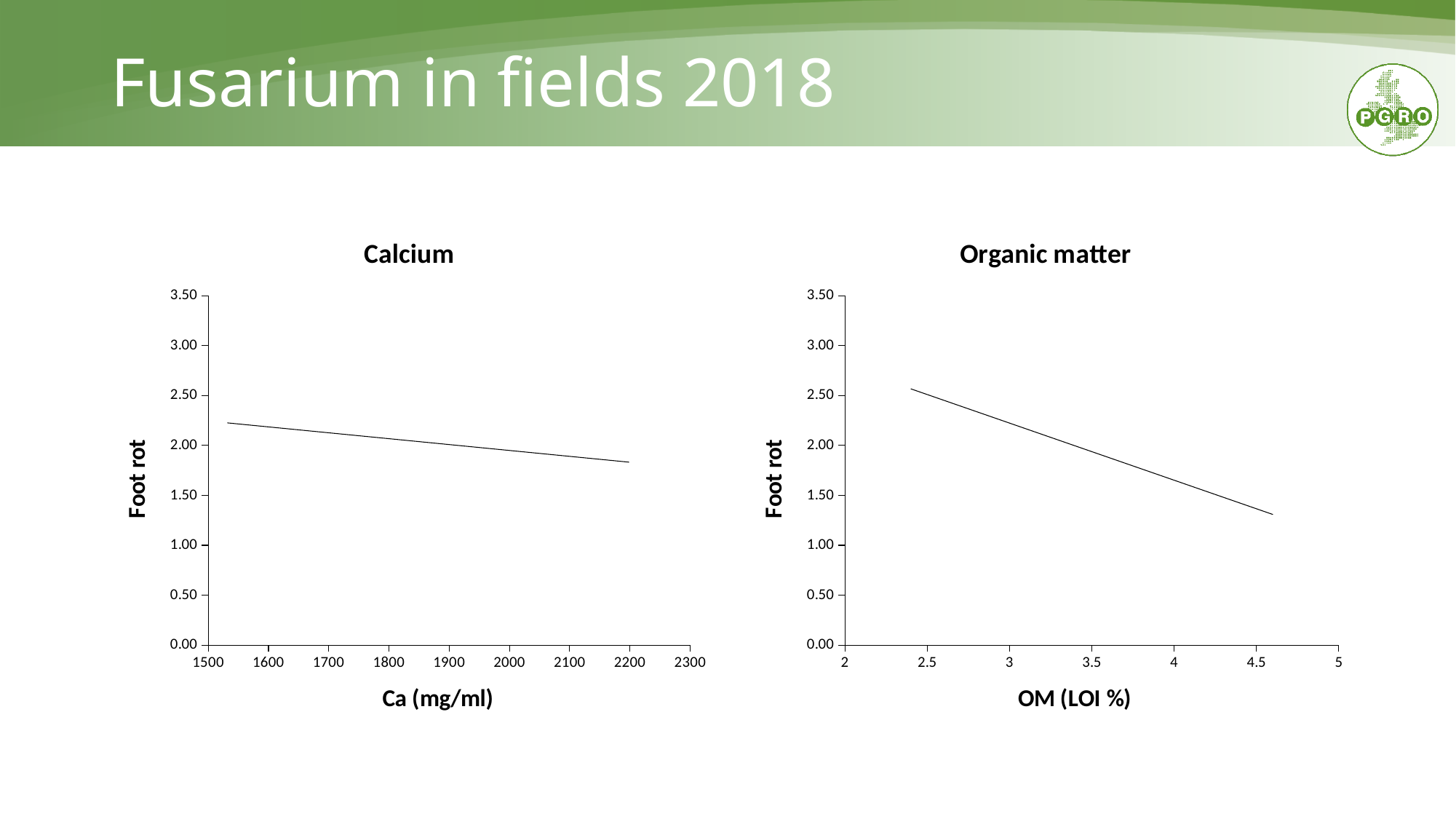
In the Organic matter chart, is the foot rot value at OM 4.5 (LOI %) greater or less than 1.50? less What is the x-axis label of the Calcium chart? Ca (mg/ml) In the Calcium chart, is the foot rot value at Ca 2200 mg/ml greater or less than 2.00? less What kind of chart is the Organic matter chart? line chart In the Organic matter chart, is the foot rot value at OM 3 (LOI %) greater or less than 2.00? greater What kind of chart is the Calcium chart? line chart In the Organic matter chart, does foot rot rise or fall as OM (LOI %) increases? fall What is the y-axis label of the Organic matter chart? Foot rot In the Calcium chart, does foot rot rise or fall as Ca (mg/ml) increases? fall How many charts are shown on the slide? 2